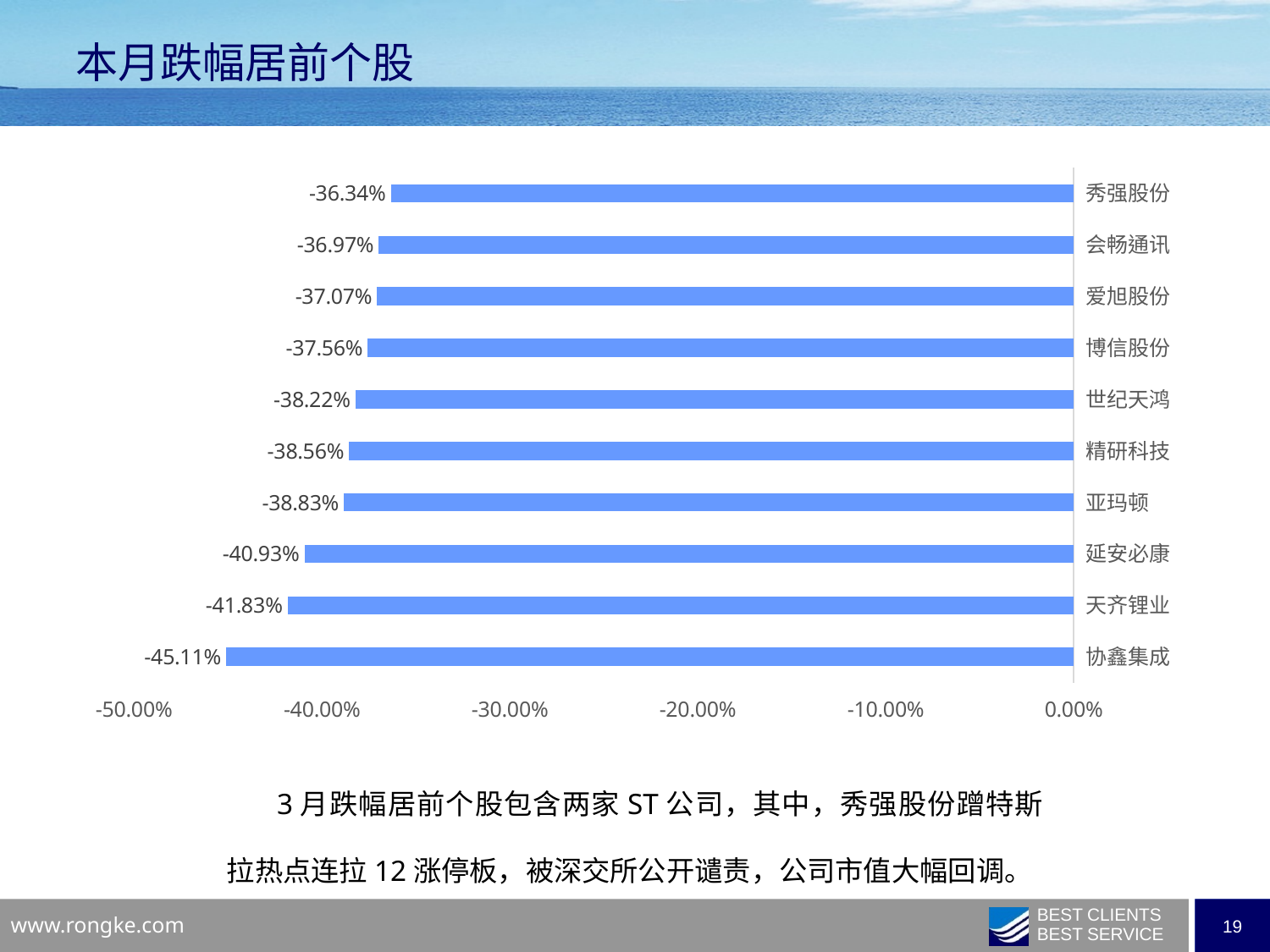
What is the value shown for 秀强股份? -36.34% What is the value shown for 天齐锂业? -41.83% Which stock has the largest decline (the lowest value) in the chart? 协鑫集成 Which stock has the smallest decline (the highest value) in the chart? 秀强股份 What is the title of the slide containing the chart? 本月跌幅居前个股 What kind of chart is shown on the slide? bar chart Which stock has a larger decline, 天齐锂业 or 延安必康? 天齐锂业 What is the value shown for 世纪天鸿? -38.22% What is the value shown for 协鑫集成? -45.11% How many stocks are shown in the chart? 10 What is the difference in percentage points between the values for 协鑫集成 and 秀强股份? 8.77 Is the value for 延安必康 greater or less than -40.00%? less